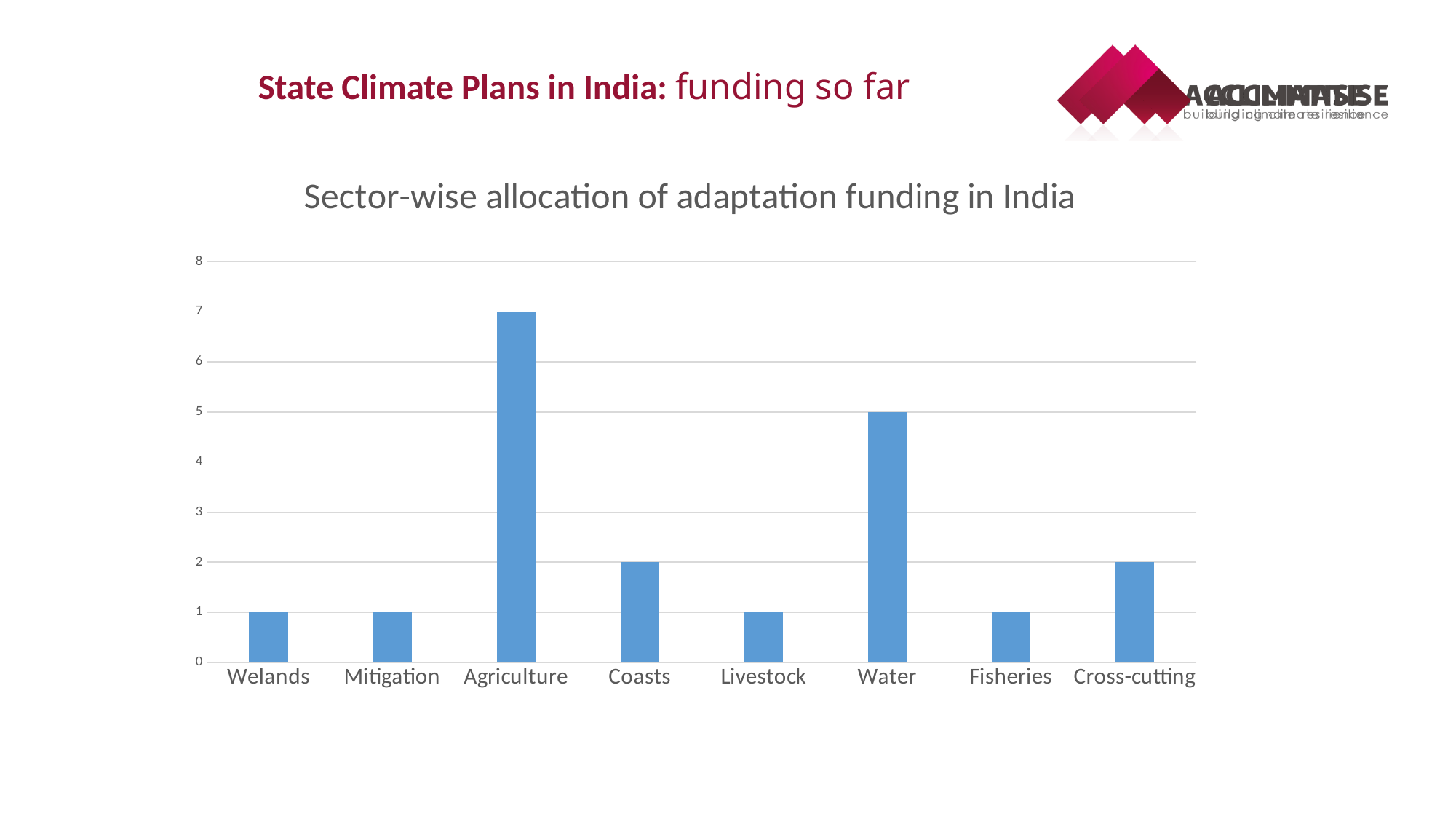
What is the title of the chart? Sector-wise allocation of adaptation funding in India Is the value for Agriculture greater or less than 6? greater What is the value for Agriculture? 7 How many sectors are shown on the x axis of the chart? 8 What is the value for Water? 5 Which is larger, the value for Water or the value for Cross-cutting? Water What is the difference between the values for Cross-cutting and Livestock? 1 What is the difference between the values for Agriculture and Water? 2 What kind of chart is shown on the slide? bar chart Which sector has the highest value in the chart? Agriculture What is the value for Coasts? 2 What is the value for Fisheries? 1